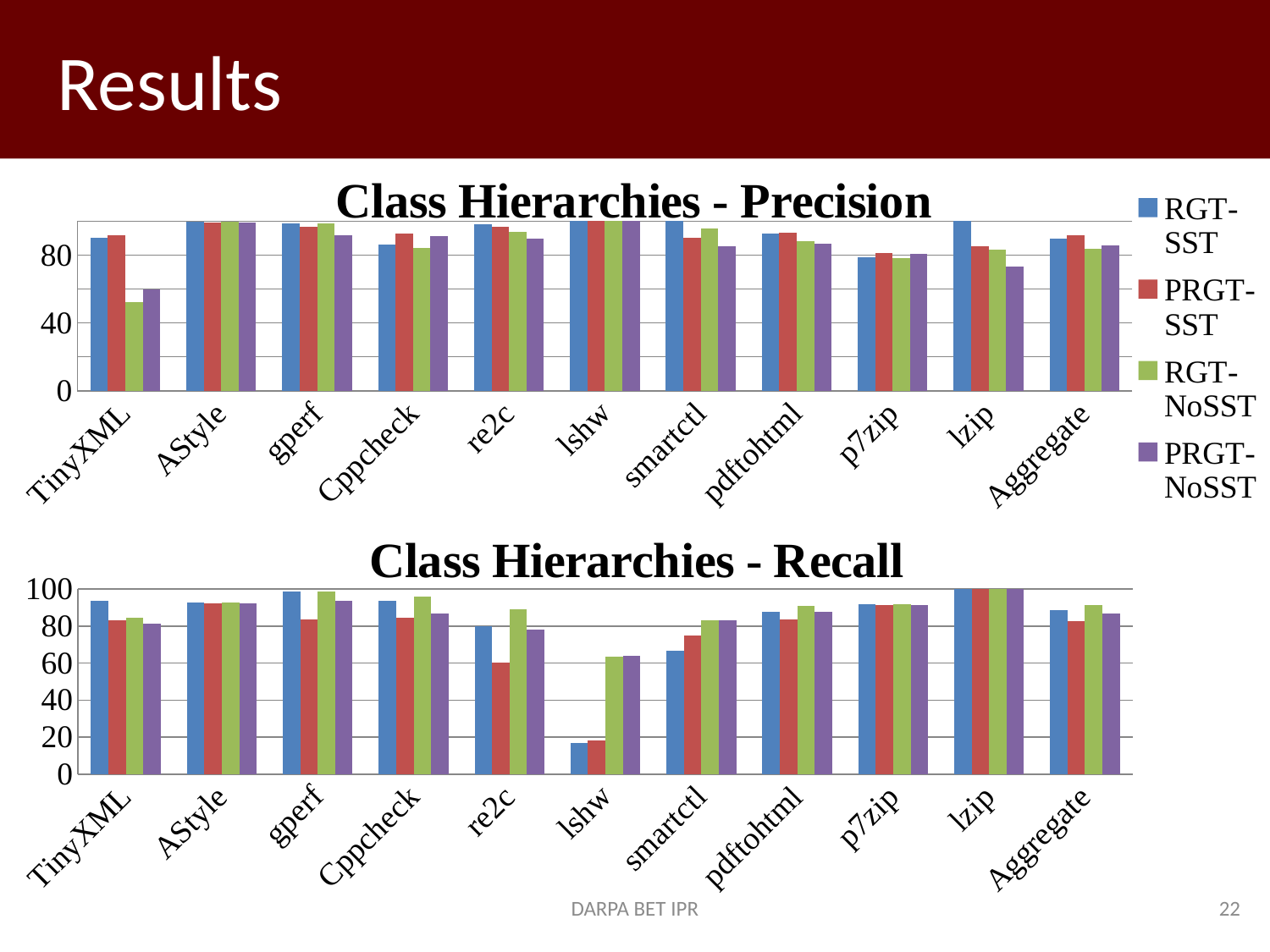
In the "Class Hierarchies - Precision" chart, is the RGT-NoSST value for TinyXML greater or less than 80? less In the "Class Hierarchies - Recall" chart, is the RGT-SST value for smartctl greater or less than 80? less How many series does the legend list for the charts on the slide? 4 In the "Class Hierarchies - Precision" chart, which category has the lowest RGT-NoSST value? TinyXML In the "Class Hierarchies - Recall" chart, which category has the lowest RGT-SST value? lshw In the "Class Hierarchies - Precision" chart, is the RGT-NoSST value for TinyXML greater or less than 40? greater What kind of chart is the "Class Hierarchies - Precision" chart? bar chart In the "Class Hierarchies - Precision" chart, for TinyXML, which is larger: the RGT-SST value or the RGT-NoSST value? RGT-SST What is the title of the lower chart on the slide? Class Hierarchies - Recall In the "Class Hierarchies - Recall" chart, for re2c, which is larger: the RGT-NoSST value or the PRGT-SST value? RGT-NoSST How many categories are shown on the x axis of the "Class Hierarchies - Recall" chart? 11